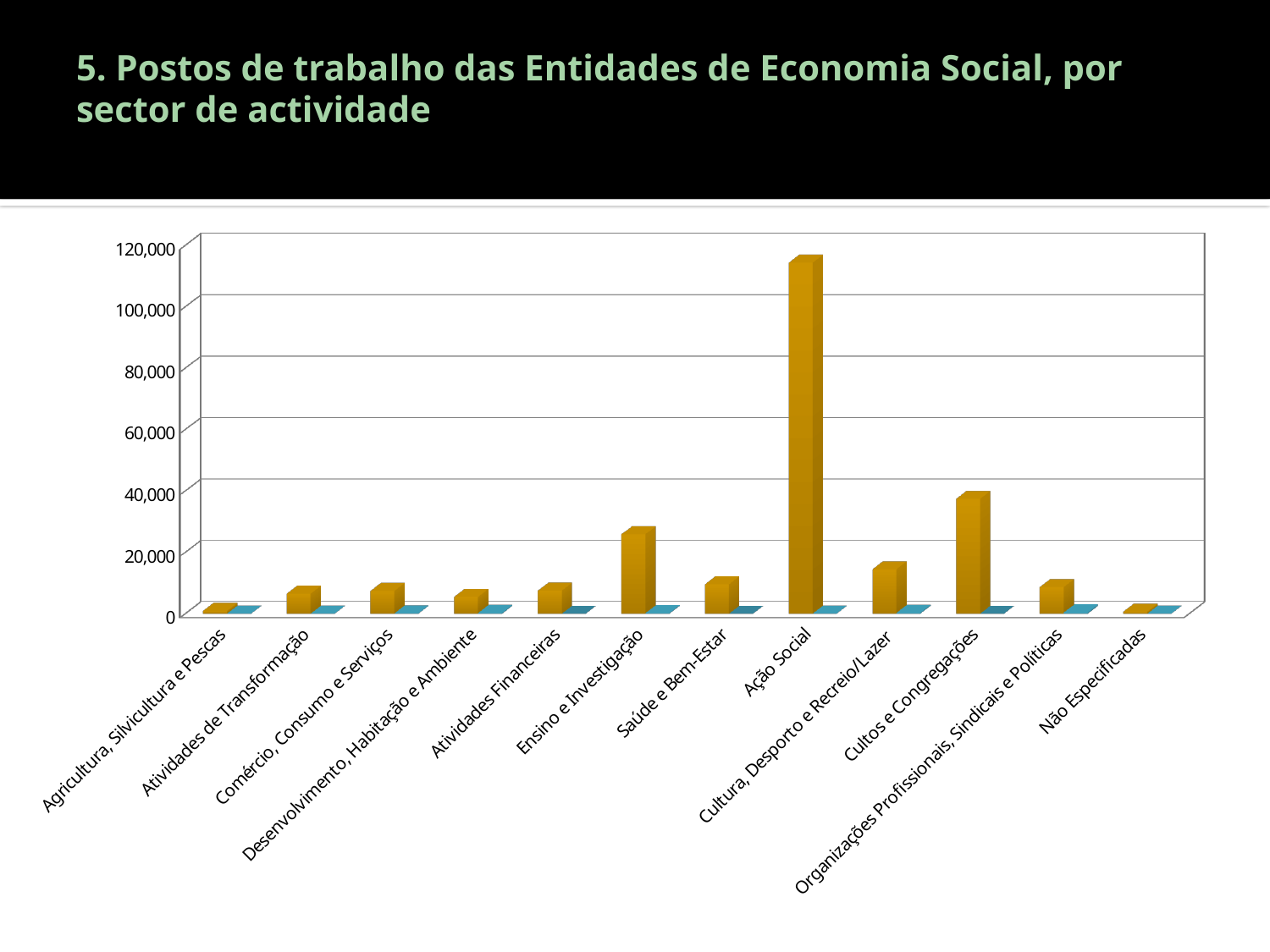
How many sectors of activity are shown along the x axis of the chart? 12 Which is larger, the value for Cultos e Congregações or the value for Ensino e Investigação? Cultos e Congregações Is the value for Ensino e Investigação greater or less than 20,000? greater What kind of chart is shown on the slide? bar chart Is the value for Saúde e Bem-Estar greater or less than 20,000? less Which is larger, the value for Ensino e Investigação or the value for Saúde e Bem-Estar? Ensino e Investigação Which sector has the highest number of postos de trabalho in the chart? Ação Social Is the value for Cultos e Congregações greater or less than 20,000? greater Which is larger, the value for Ação Social or the value for Cultos e Congregações? Ação Social What is the highest value shown on the vertical axis of the chart? 120,000